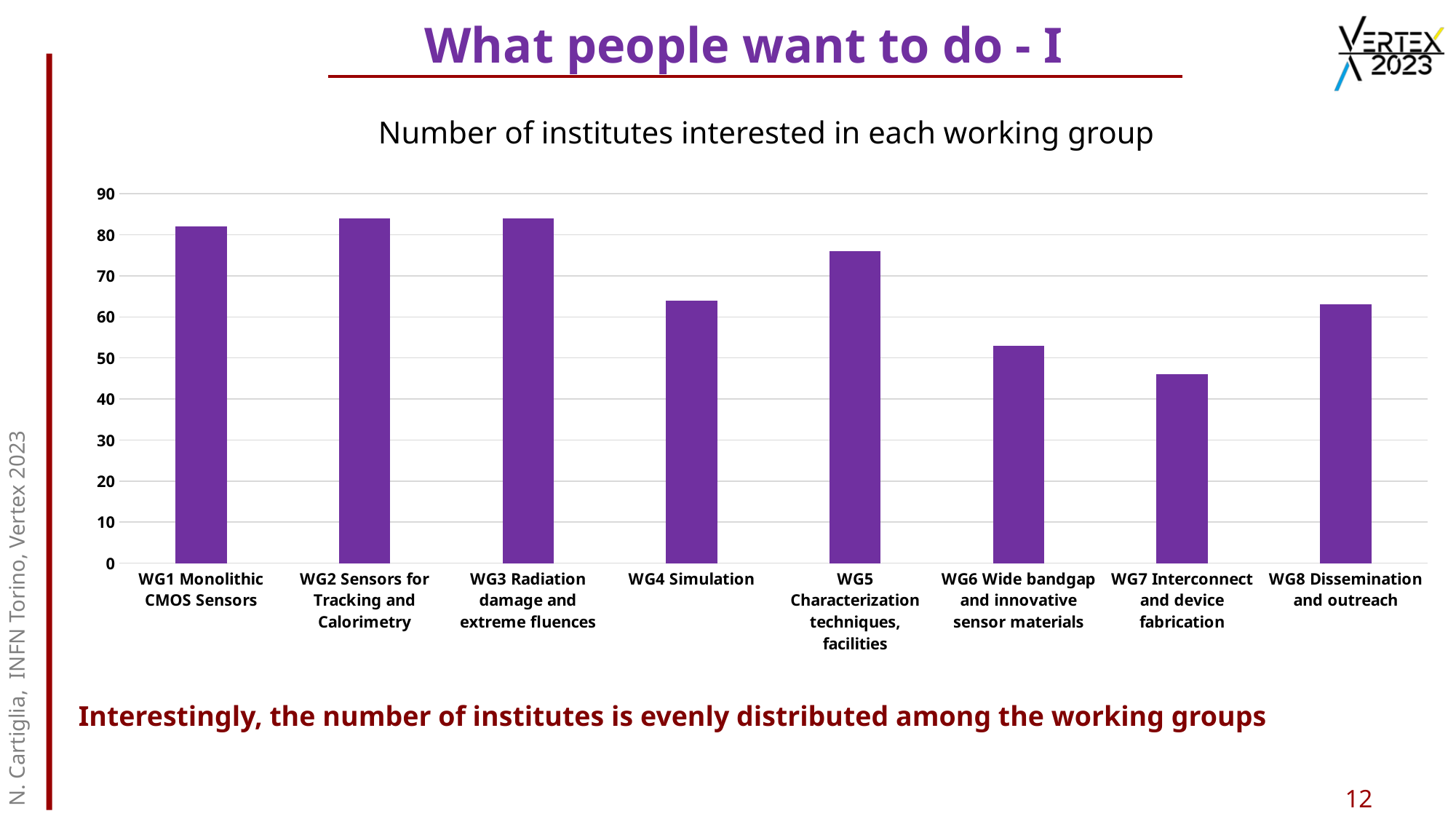
Which has more interested institutes, WG1 Monolithic CMOS Sensors or WG4 Simulation? WG1 Monolithic CMOS Sensors What kind of chart is shown on the slide? bar chart Which has more interested institutes, WG5 Characterization techniques, facilities or WG6 Wide bandgap and innovative sensor materials? WG5 Characterization techniques, facilities What is the highest value shown on the y axis of the chart? 90 Is the value for WG5 Characterization techniques, facilities greater or less than 70? greater What is the title of the chart? Number of institutes interested in each working group Is the value for WG1 Monolithic CMOS Sensors greater or less than 80? greater How many working groups are shown on the x axis of the chart? 8 Is the value for WG6 Wide bandgap and innovative sensor materials greater or less than 60? less Which working group has the lowest number of interested institutes? WG7 Interconnect and device fabrication